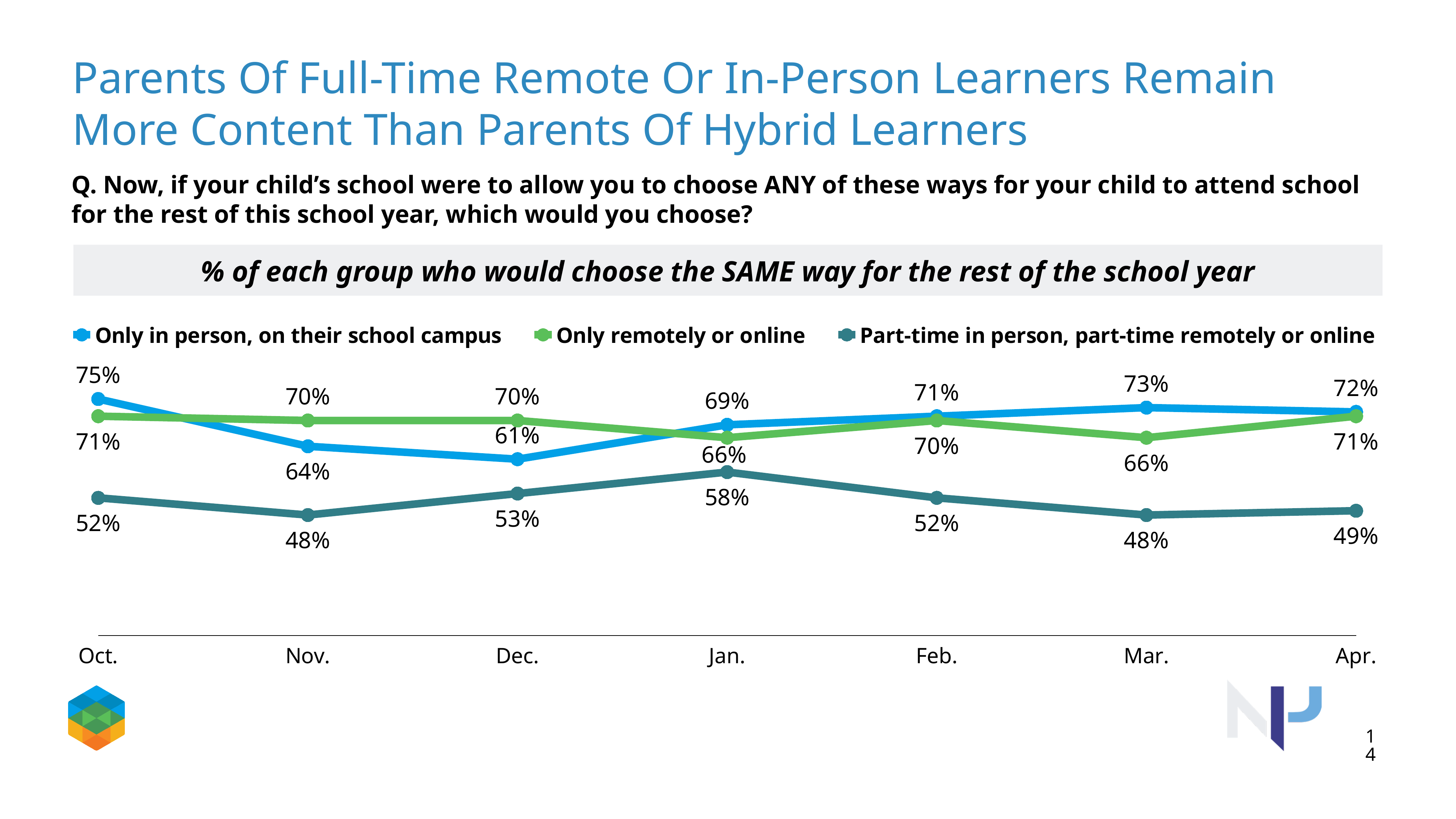
What percentage of parents of only-in-person learners would choose the same way in Oct.? 75% What is the value for 'Part-time in person, part-time remotely or online' in Jan.? 58% What is the value for 'Only remotely or online' in Jan.? 66% In which month is the 'Only in person, on their school campus' series lowest? Dec. What is the value for 'Only in person, on their school campus' in Dec.? 61% In Nov., which is larger: 'Only remotely or online' or 'Only in person, on their school campus'? Only remotely or online In which month is the 'Part-time in person, part-time remotely or online' series highest? Jan. What kind of chart is shown on the slide? Line chart What is the difference between the 'Only in person' and 'Part-time' values in Apr.? 23 percentage points How many series does the legend list? 3 How many months are shown on the x axis? 7 Does the 'Only in person, on their school campus' series rise or fall from Dec. to Mar.? Rise